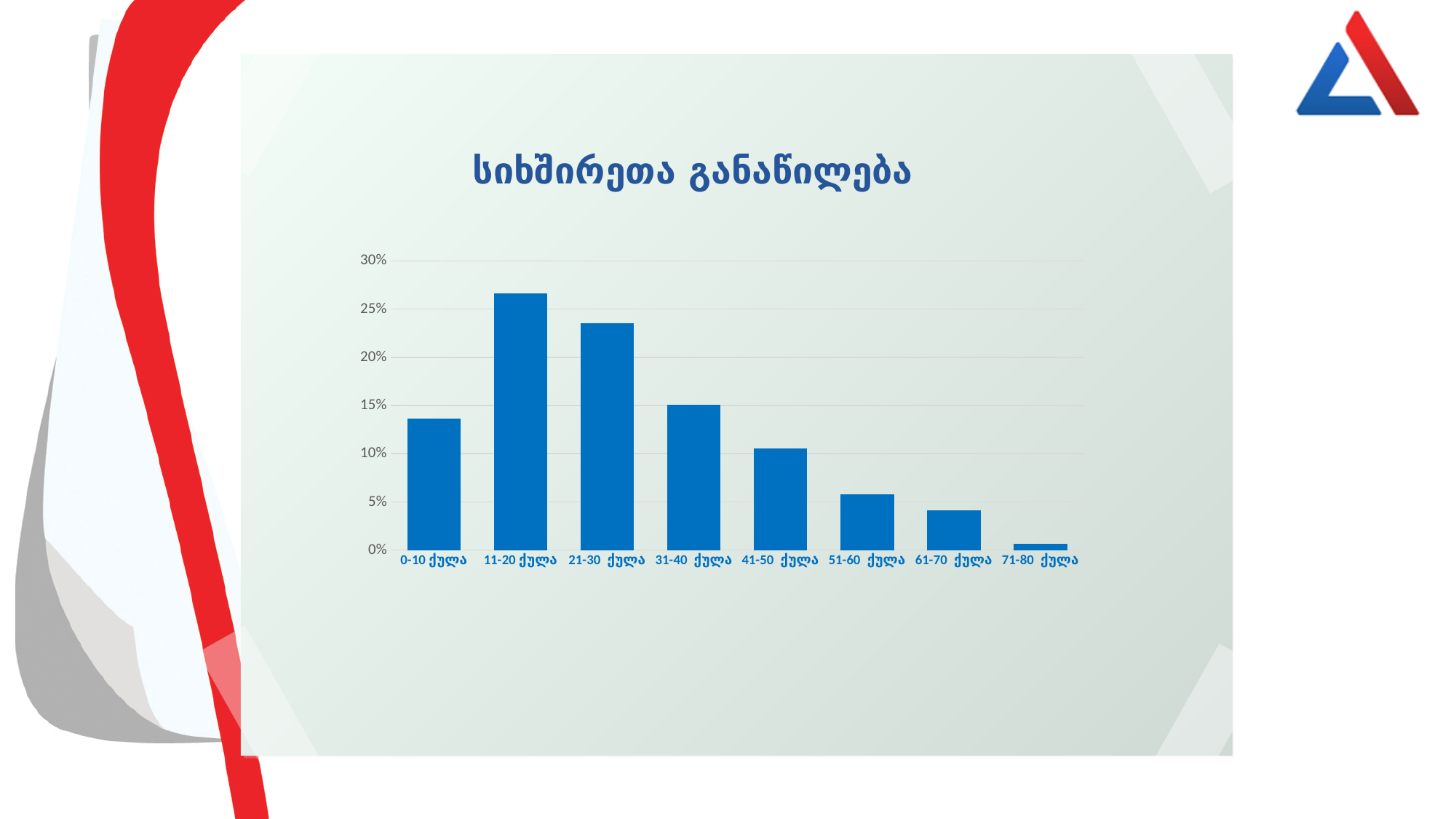
How many score categories are shown on the x axis? 8 Do the values rise or fall from 11-20 ქულა to 71-80 ქულა? fall Which is larger, the value for 0-10 ქულა or the value for 31-40 ქულა? 31-40 ქულა Which category has the lowest bar? 71-80 ქულა Which is larger, the value for 21-30 ქულა or the value for 41-50 ქულა? 21-30 ქულა Is the value for 11-20 ქულა greater or less than 25%? greater Is the value for 51-60 ქულა greater or less than 5%? greater Is the value for 61-70 ქულა greater or less than 5%? less Which category has the highest bar? 11-20 ქულა What is the title of the chart? სიხშირეთა განაწილება What kind of chart is shown on the slide? bar chart